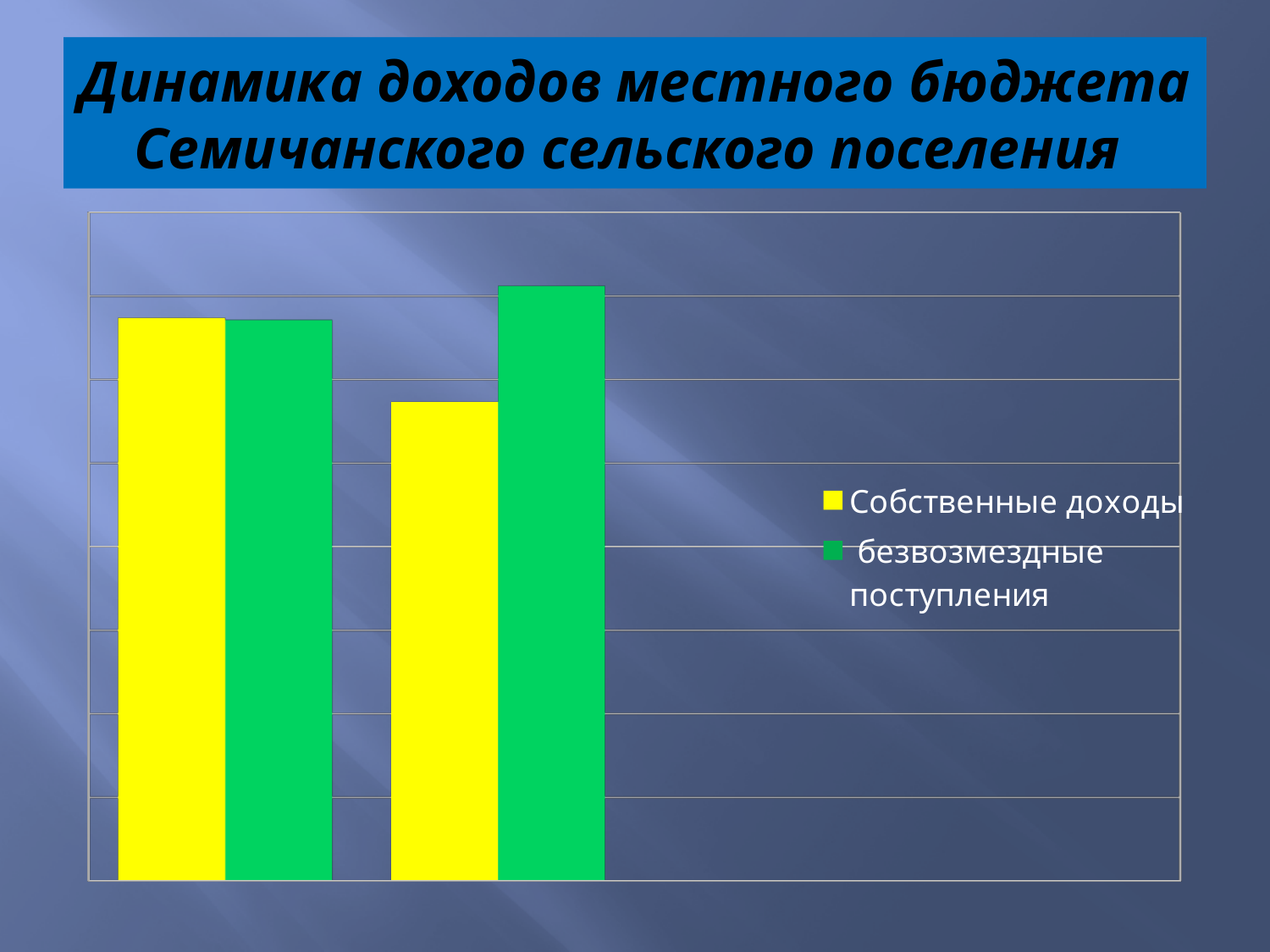
How many series does the legend list? 2 Which bar is the tallest in the chart? безвозмездные поступления in the second group How many bars are plotted in total in the chart? 4 How many groups of bars are plotted in the chart? 2 What colour represents the series Собственные доходы in the legend? yellow In the second (right) group of bars, which series has the larger value: Собственные доходы or безвозмездные поступления? безвозмездные поступления Which bar is the shortest in the chart? Собственные доходы in the second group What is the title of the slide containing the chart? Динамика доходов местного бюджета Семичанского сельского поселения What kind of chart is shown on the slide? bar chart Does the value of Собственные доходы rise or fall from the first group to the second group? fall Does the value of безвозмездные поступления rise or fall from the first group to the second group? rise